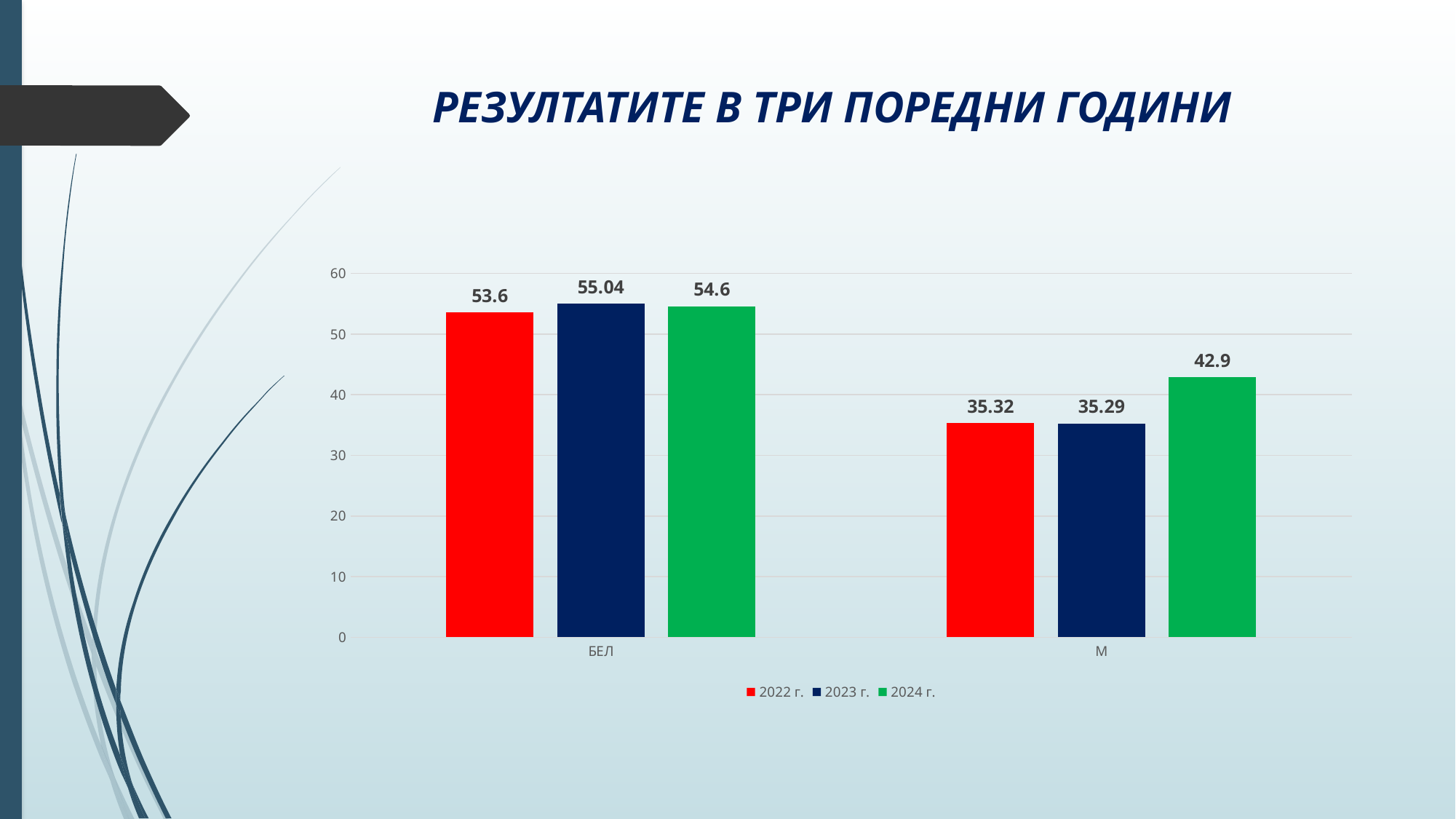
What is the difference between the 2023 г. and 2024 г. values for БЕЛ? 0.44 Which year has the highest value for М? 2024 г. What kind of chart is shown on the slide? Bar chart What is the value for М in 2022 г.? 35.32 Which year has the highest value for БЕЛ? 2023 г. What is the difference between the 2024 г. and 2022 г. values for М? 7.58 What is the value for БЕЛ in 2023 г.? 55.04 What colour are the bars for 2023 г.? Dark blue How many series does the legend list? 3 Which is larger: the 2024 г. value for БЕЛ or the 2024 г. value for М? БЕЛ What is the value for М in 2024 г.? 42.9 What is the value for БЕЛ in 2022 г.? 53.6